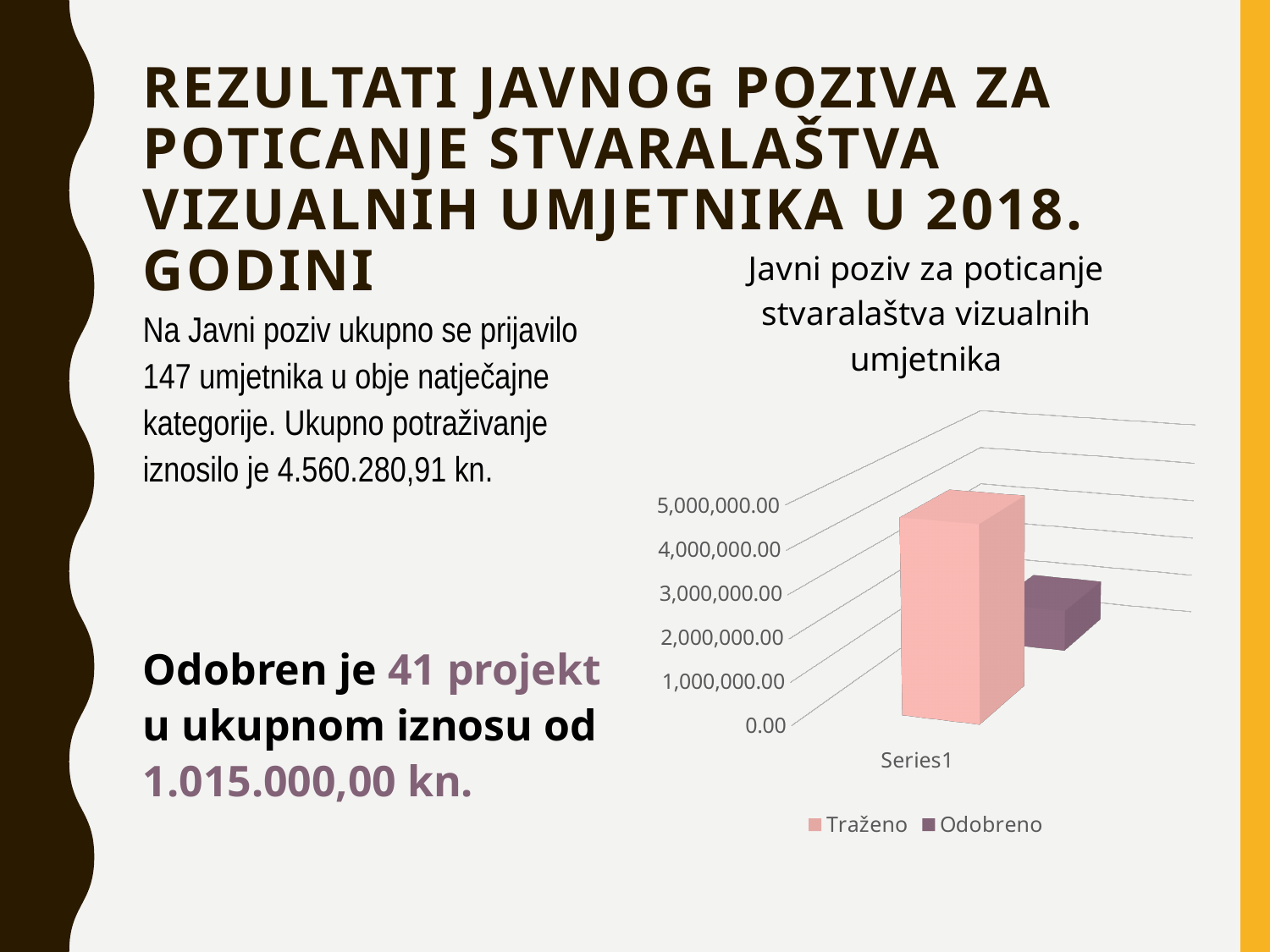
How many categories are shown on the x axis of the chart? 1 Is the value for Odobreno greater or less than 3,000,000.00? less What is the category label on the x axis? Series1 Is the value for Traženo greater or less than 4,000,000.00? greater What are the two series named in the legend? Traženo and Odobreno Which series has the lowest bar in the chart? Odobreno Which series has the taller bar, Traženo or Odobreno? Traženo What kind of chart is shown on the slide? bar chart What is the highest tick value shown on the vertical axis? 5,000,000.00 How many series does the chart legend list? 2 What is the title of the chart? Javni poziv za poticanje stvaralaštva vizualnih umjetnika